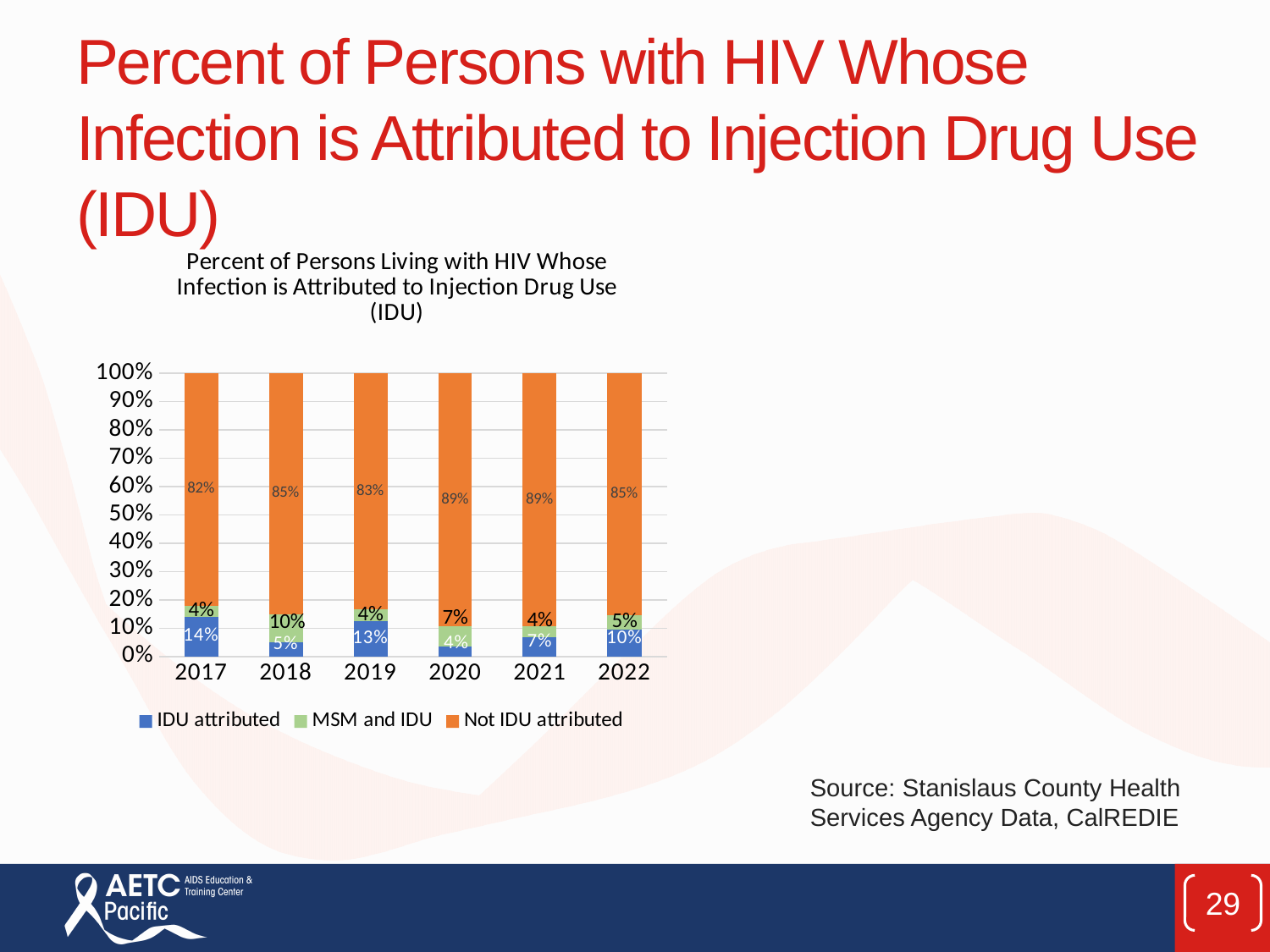
Which is larger, the MSM and IDU value for 2020 or for 2021? 2020 What is the Not IDU attributed value for 2020? 89% What type of chart is shown on the slide? Stacked bar chart What is the difference between the IDU attributed values for 2017 and 2018? 9% Which series is shown in orange in the chart? Not IDU attributed What percentage of persons with HIV had infection attributed to IDU (IDU attributed) in 2017? 14% What is the IDU attributed value for 2022? 10% How many years are shown on the x axis of the chart? 6 What is the MSM and IDU value for 2018? 10% In which year is the IDU attributed share the lowest? 2020 In which year is the IDU attributed share the highest? 2017 How many series does the chart legend list? 3